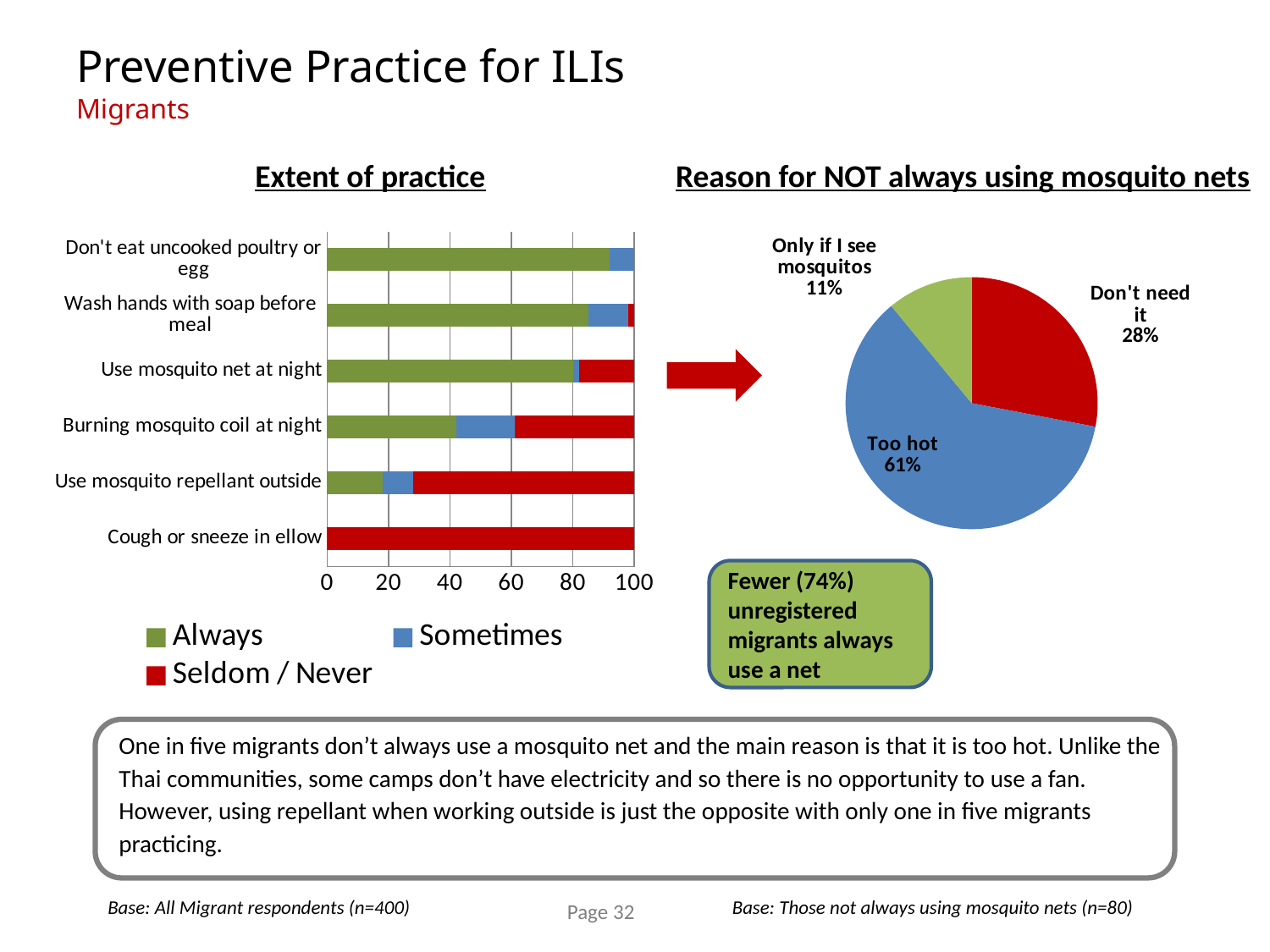
On the 'Reason for NOT always using mosquito nets' pie chart, which reason has the largest slice? Too hot On the 'Extent of practice' chart, is the 'Always' value for 'Don't eat uncooked poultry or egg' greater or less than 80? greater On the 'Reason for NOT always using mosquito nets' pie chart, how many slices are there? 3 On the 'Reason for NOT always using mosquito nets' pie chart, what share is labelled for 'Don't need it'? 28% On the 'Extent of practice' chart, is the 'Always' value for 'Use mosquito repellant outside' greater or less than 40? less How many series does the legend of the 'Extent of practice' chart list? 3 On the 'Extent of practice' chart, which practice has the largest 'Always' segment? Don't eat uncooked poultry or egg How many practices (categories) are shown on the 'Extent of practice' chart? 6 On the 'Reason for NOT always using mosquito nets' pie chart, how many percentage points larger is 'Too hot' than 'Don't need it'? 33 On the 'Reason for NOT always using mosquito nets' pie chart, what share is labelled for 'Too hot'? 61% What kind of chart is the 'Extent of practice' chart? Stacked bar chart On the 'Reason for NOT always using mosquito nets' pie chart, which reason has the smallest slice? Only if I see mosquitos